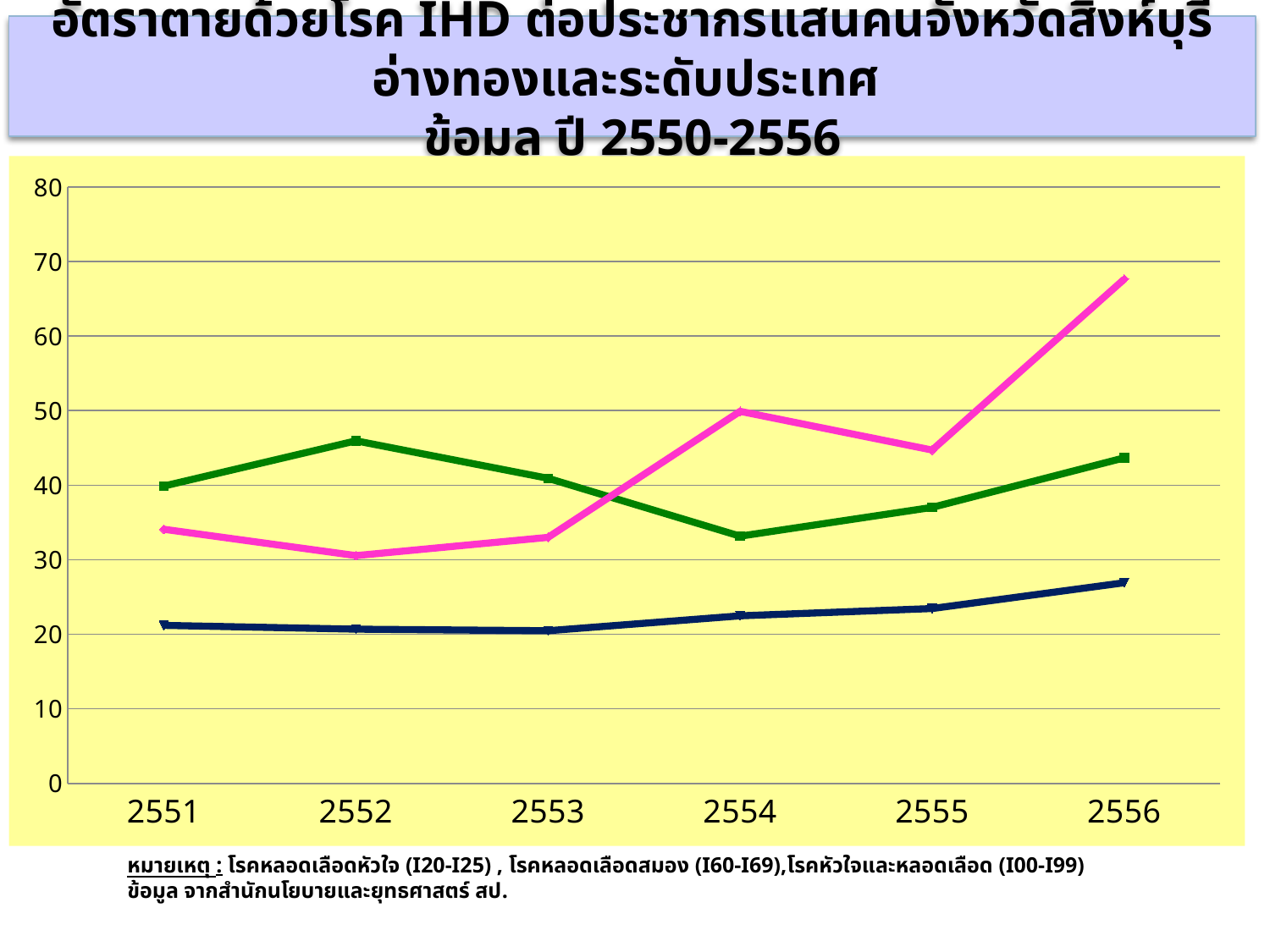
Is the value of the green line in 2554 greater or less than 40? less Does the dark blue line rise or fall from 2553 to 2556? rise How many lines are plotted on the chart? 3 Is the value of the dark blue line in 2556 greater or less than 30? less Is the value of the green line in 2552 greater or less than 40? greater In 2551, which line has the higher value, the green line or the pink line? green line How many years are shown along the x axis of the chart? 6 What kind of chart is shown on the slide? line chart In 2556, which line has the higher value, the pink line or the green line? pink line In which year does the pink line reach its highest value? 2556